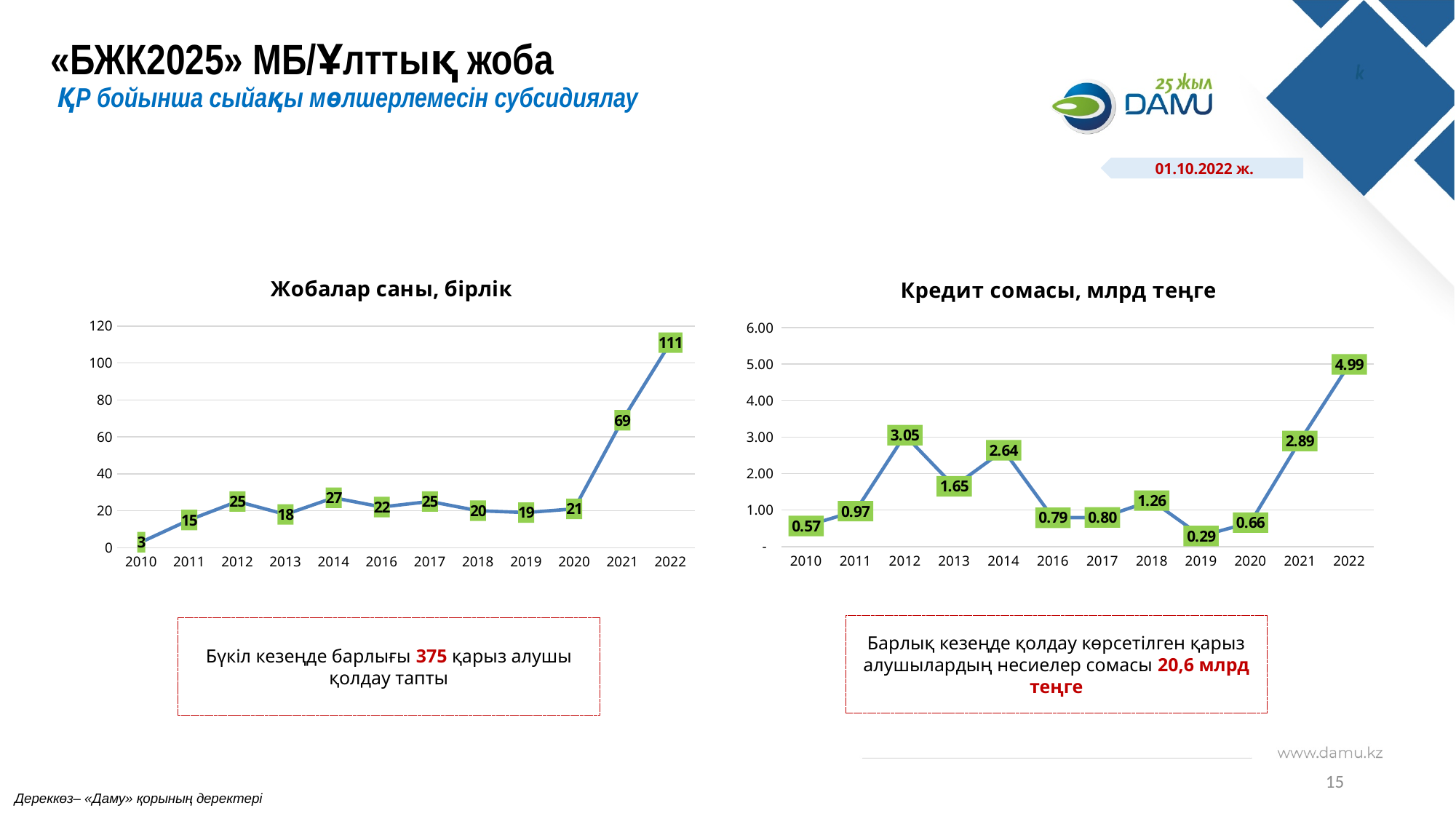
What type of chart is the chart titled "Кредит сомасы, млрд теңге"? line chart In the chart titled "Жобалар саны, бірлік", which year has the lowest value? 2010 In the chart titled "Кредит сомасы, млрд теңге", which is larger, the value for 2014 or the value for 2013? 2014 In the chart titled "Кредит сомасы, млрд теңге", what is the value for 2012? 3.05 In the chart titled "Кредит сомасы, млрд теңге", what is the difference between the values for 2022 and 2021? 2.10 In the chart titled "Жобалар саны, бірлік", do the values rise or fall from 2020 to 2022? rise In the chart titled "Жобалар саны, бірлік", how many years are plotted? 12 In the chart titled "Жобалар саны, бірлік", what is the value for 2021? 69 In the chart titled "Кредит сомасы, млрд теңге", which year has the lowest value? 2019 In the chart titled "Кредит сомасы, млрд теңге", which year has the highest value? 2022 In the chart titled "Жобалар саны, бірлік", what is the difference between the values for 2022 and 2021? 42 In the chart titled "Жобалар саны, бірлік", which year has the highest value? 2022